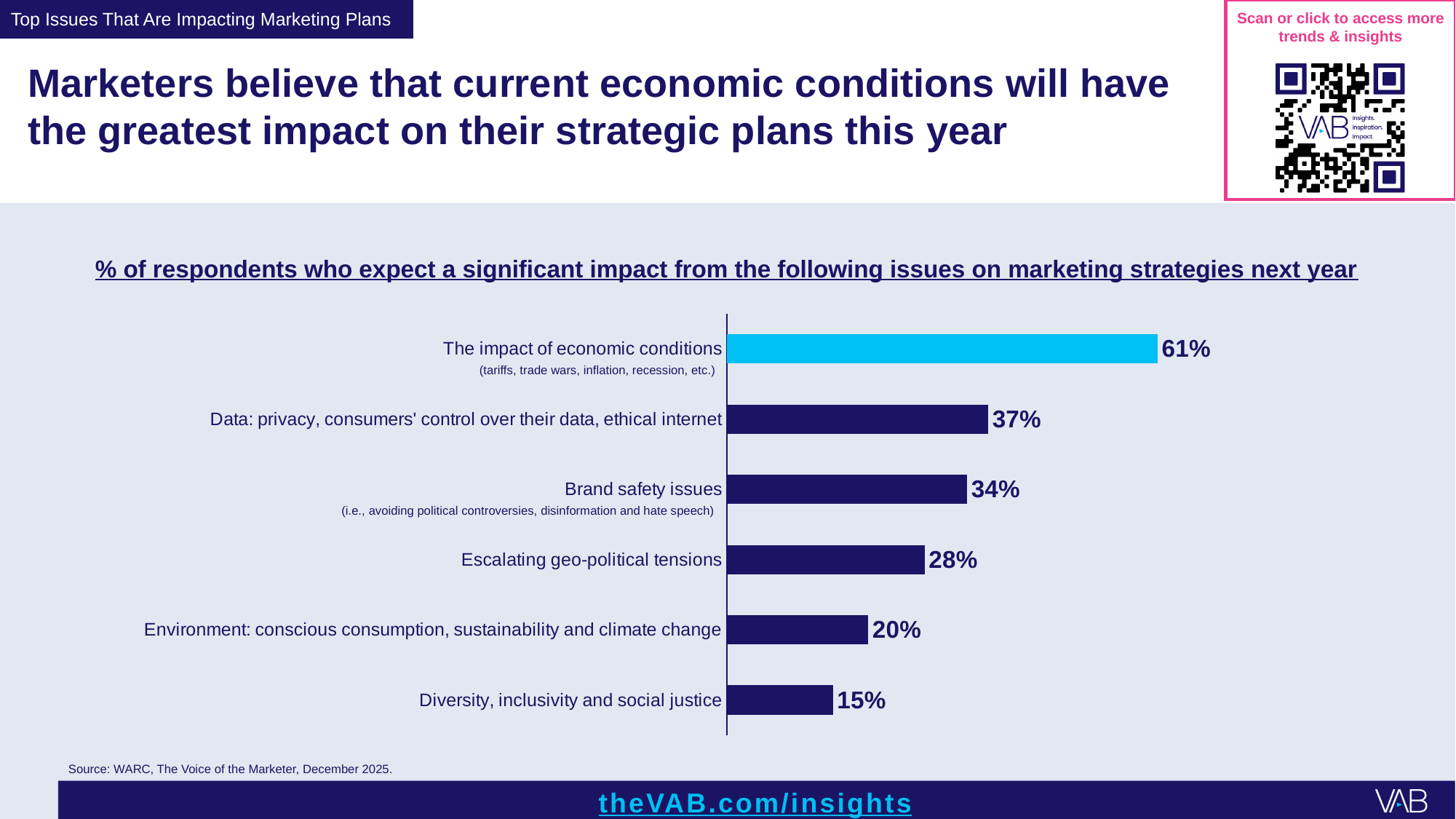
What percentage of respondents expect a significant impact from the impact of economic conditions? 61% What is the value for Diversity, inclusivity and social justice? 15% What is the difference between the value for Environment: conscious consumption, sustainability and climate change and the value for Diversity, inclusivity and social justice? 5% What is the difference between the value for the impact of economic conditions and the value for Data: privacy, consumers' control over their data, ethical internet? 24% Which bar is shown in a different colour (light blue) from the others? The impact of economic conditions What kind of chart is shown on the slide? Bar chart Which is larger: the value for Brand safety issues or the value for Escalating geo-political tensions? Brand safety issues What is the value for Escalating geo-political tensions? 28% Which issue has the lowest percentage? Diversity, inclusivity and social justice What is the value for Brand safety issues? 34% How many issues are shown in the chart? 6 Which issue has the highest percentage of respondents expecting a significant impact? The impact of economic conditions